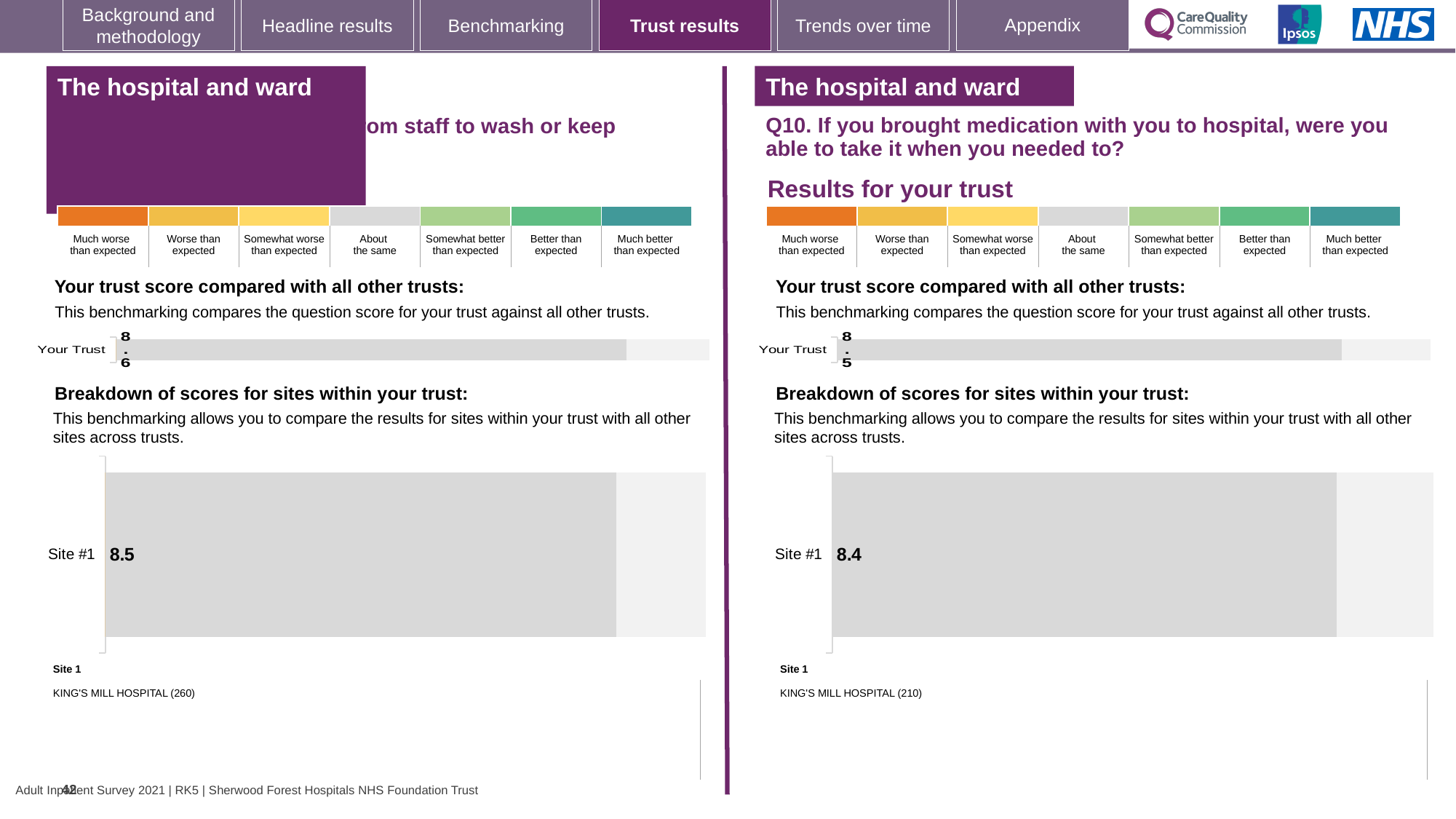
On the left-hand chart, what is the score shown for Site #1? 8.5 What kind of chart is used to show the Site #1 score on the right-hand side for Q10? Bar chart On the right-hand chart for Q10, what is the difference between the Your Trust score and the Site #1 score? 0.1 On the right-hand side for Q10, which hospital is listed as Site 1? KING'S MILL HOSPITAL (210) On the right-hand chart for Q10, what is the score shown for Site #1? 8.4 How many sites are shown in the site breakdown chart on the right-hand side for Q10? 1 On the right-hand chart for Q10 (medication brought to hospital), what is the score shown for Your Trust? 8.5 Which is larger: the Your Trust score on the left-hand chart or the Your Trust score on the right-hand chart for Q10? Left-hand chart (8.6) Which is larger: the Site #1 score on the left-hand chart or the Site #1 score on the right-hand chart for Q10? Left-hand chart (8.5) On the left-hand chart, what is the difference between the Your Trust score and the Site #1 score? 0.1 On the left-hand side, which hospital is listed as Site 1? KING'S MILL HOSPITAL (260) On the left-hand chart, what is the score shown for Your Trust? 8.6